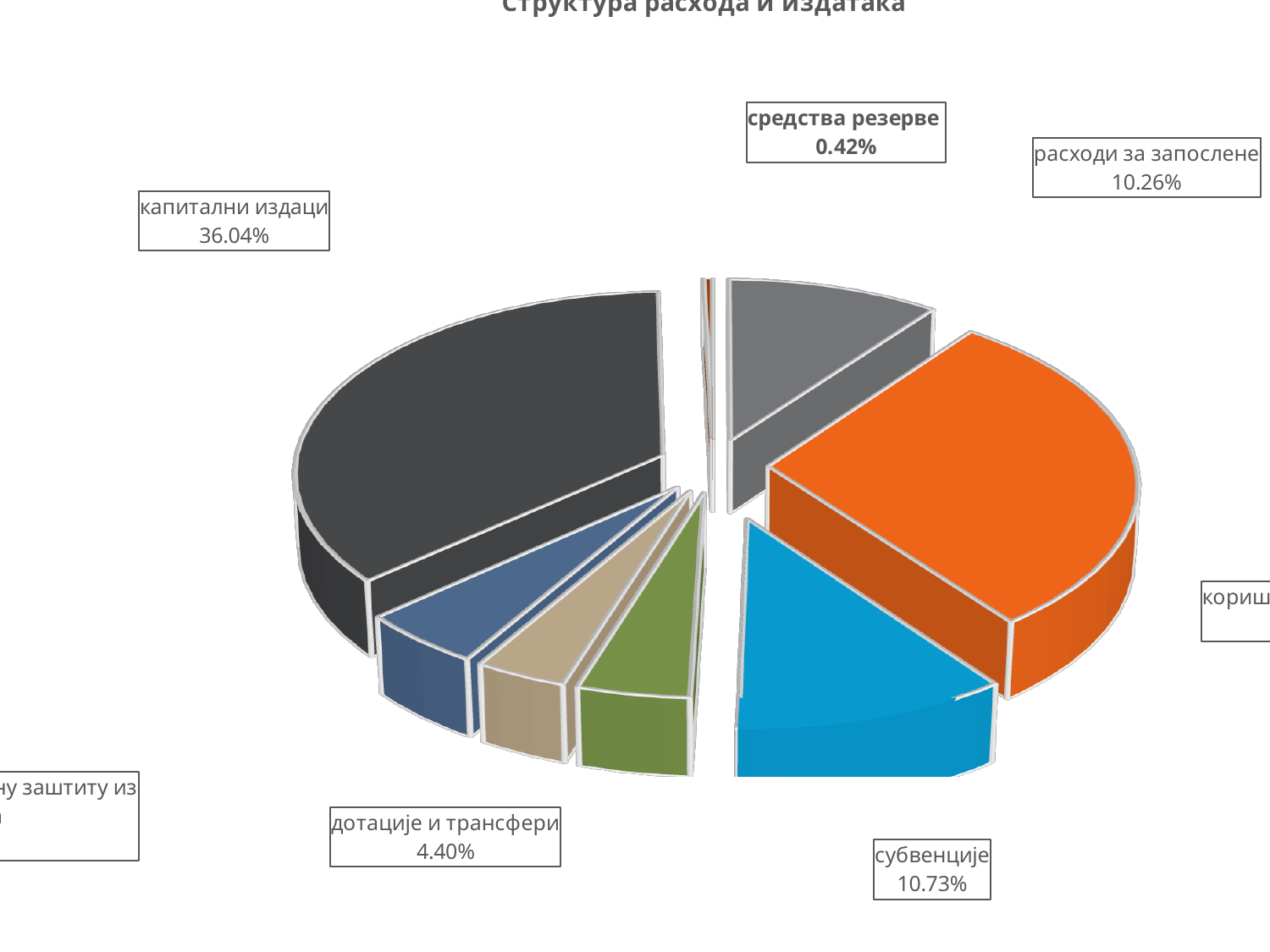
What is the difference between the shares of капитални издаци and субвенције? 25.31% What percentage is labelled for средства резерве? 0.42% What share of the pie does капитални издаци represent? 36.04% Which is larger, the share for субвенције or for расходи за запослене? субвенције By how much does the share of дотације и трансфери exceed that of средства резерве? 3.98% Which labelled category has the smallest share of the pie? средства резерве What share is shown for дотације и трансфери? 4.40% What is the title of the chart? Структура расхода и издатака What percentage is shown for субвенције? 10.73% Which labelled category has the largest share of the pie? капитални издаци What type of chart is shown on the slide? pie chart What is the value labelled for расходи за запослене? 10.26%